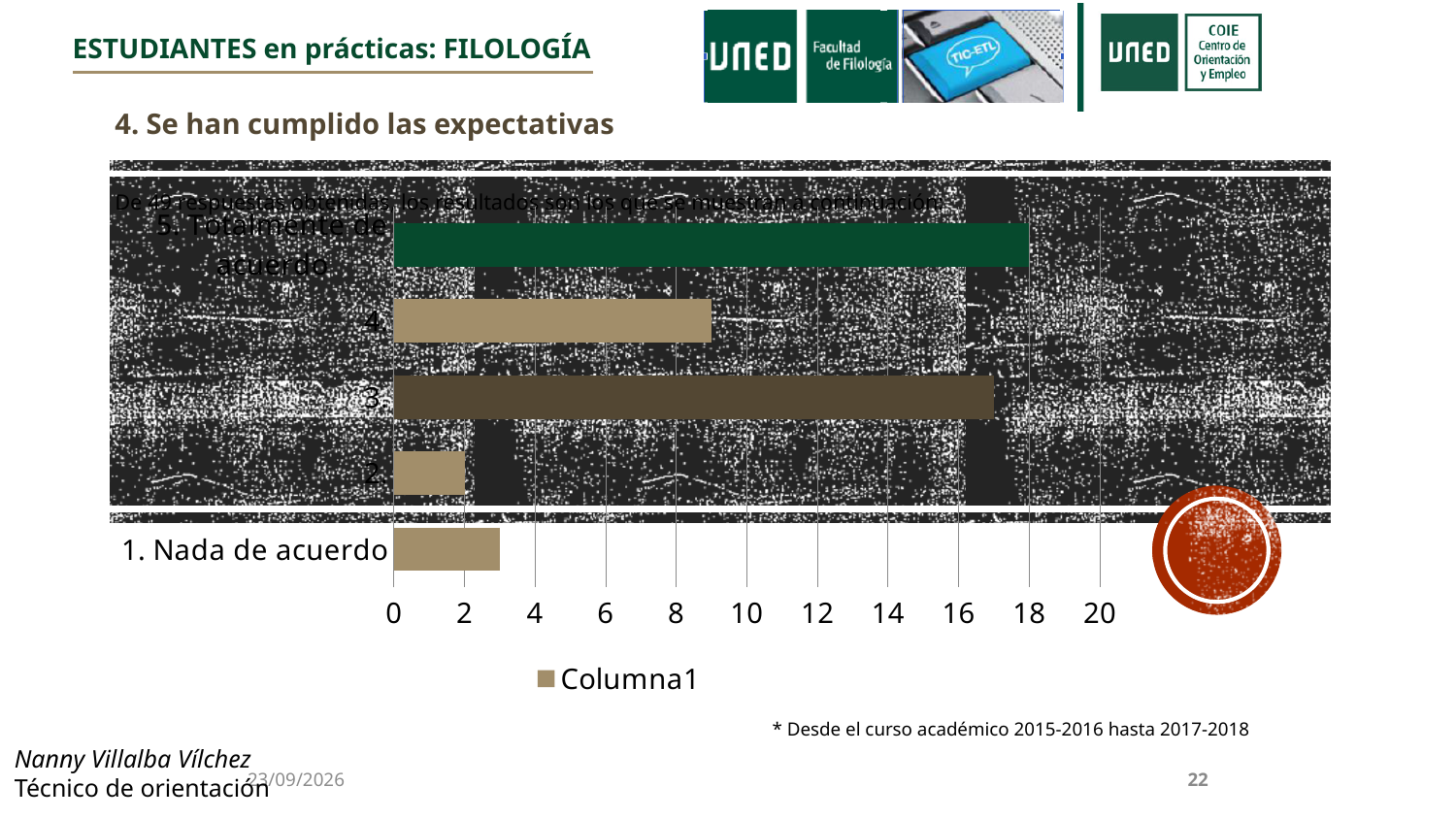
How many categories does the bar chart show? 5 What is the value for category '2'? 2 Which category has the highest value? 5. Totalmente de acuerdo Which has the larger value, category '3' or category '4'? 3 How many series does the legend list? 1 Is the value for category '3' greater or less than 16? greater Which category has the lowest value? 2 What is the legend entry of the chart? Columna1 Is the value for '1. Nada de acuerdo' greater or less than 4? less What kind of chart is shown on the slide? bar chart What is the value for '5. Totalmente de acuerdo'? 18 Is the value for category '4' greater or less than 8? greater